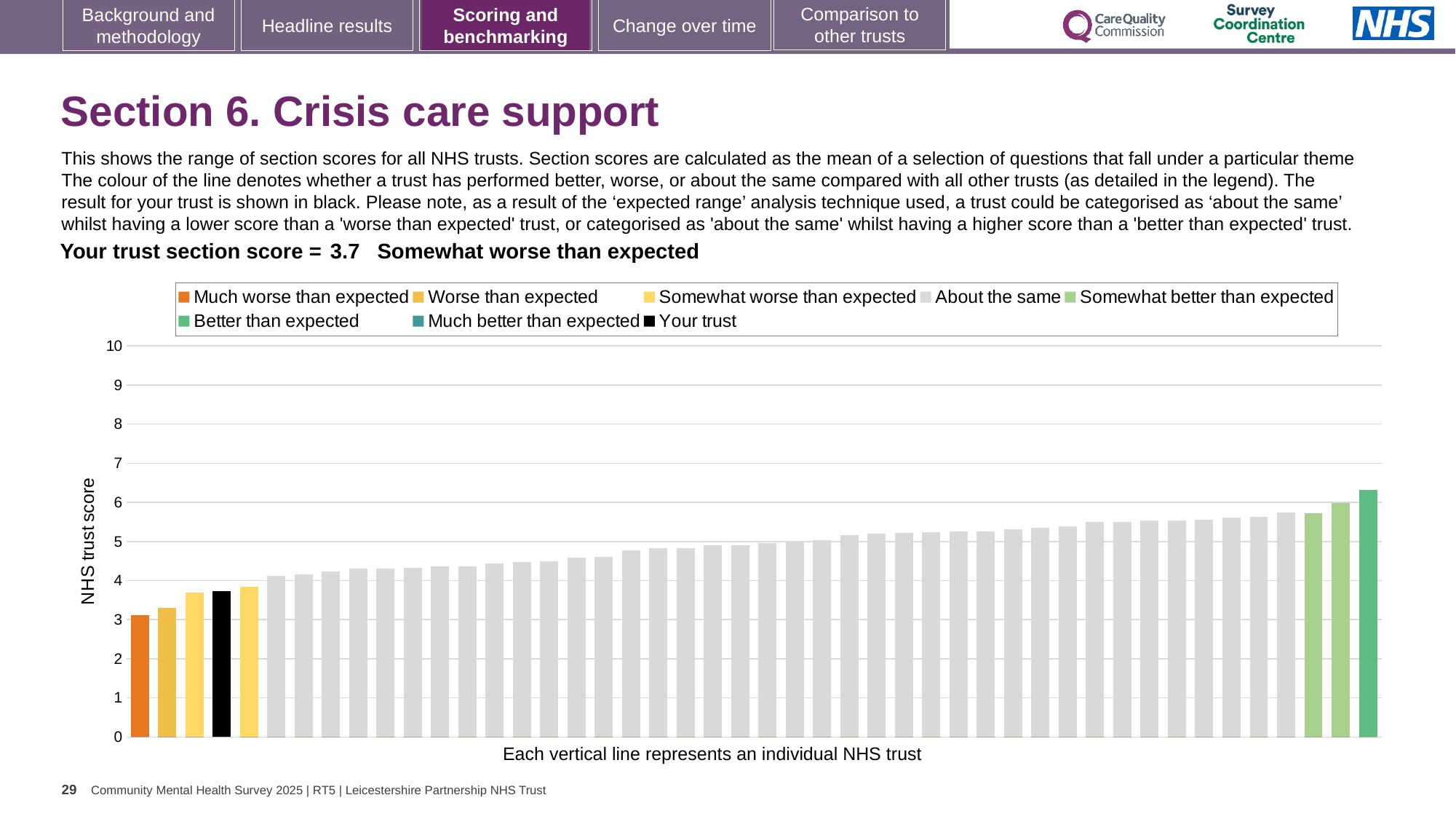
Is the value of the tallest bar greater or less than 6? greater Do the bar values rise or fall from left to right along the x axis? Rise How many bars are coloured as 'Somewhat better than expected'? 2 What kind of chart is shown on the slide? Bar chart Which is taller: the black 'Your trust' bar or the orange 'Much worse than expected' bar? The black 'Your trust' bar What is the label on the vertical axis of the chart? NHS trust score Is the value of the shortest bar greater or less than 4? less Which legend category does the tallest bar belong to? Better than expected What is the section score for your trust? 3.7 Is the value of the black 'Your trust' bar greater or less than 4? less Which legend category does the shortest bar belong to? Much worse than expected How many entries does the chart legend list? 8